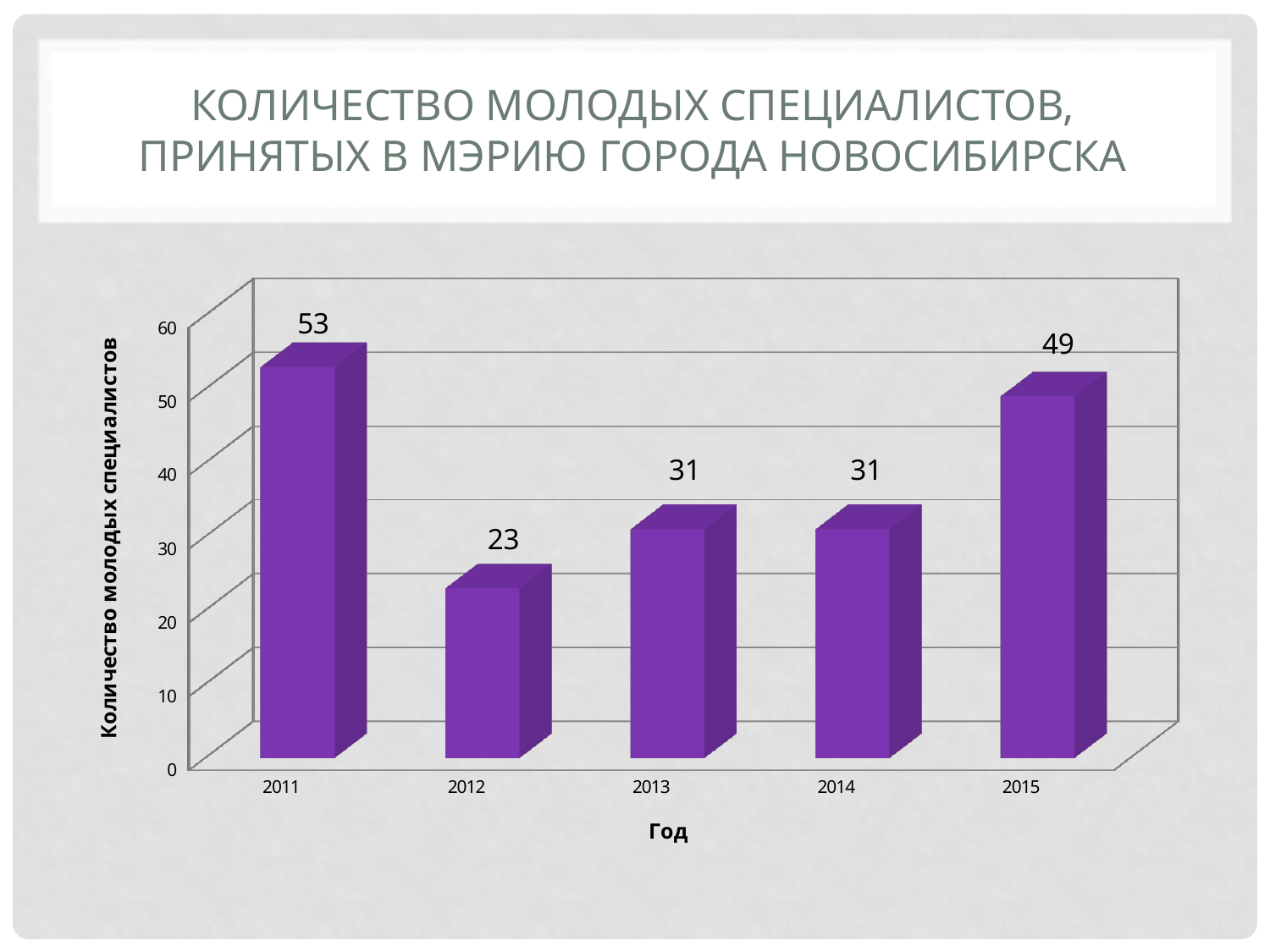
Which year has the highest value? 2011 How many years are shown on the x axis? 5 What is the difference between the values for 2015 and 2014? 18 Which is larger, the value for 2011 or the value for 2015? 2011 What kind of chart is shown on the slide? bar chart What is the value for 2012? 23 Is the value for 2013 greater or less than 40? less What is the value for 2011? 53 What is the label of the x axis? Год What is the difference between the values for 2011 and 2012? 30 What is the value for 2015? 49 Which year has the lowest value? 2012